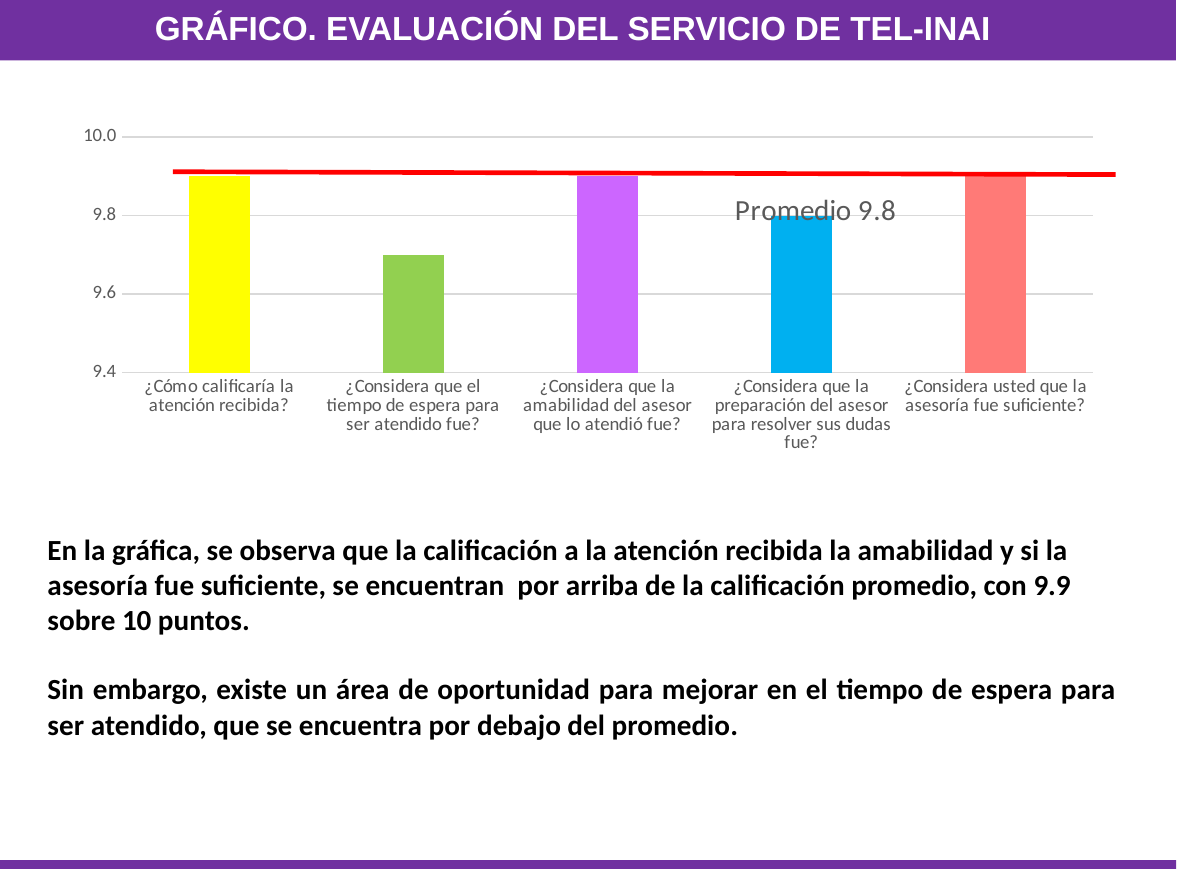
Is the value for '¿Considera que la amabilidad del asesor que lo atendió fue?' greater or less than 9.8? greater Is the value for '¿Considera usted que la asesoría fue suficiente?' greater or less than 9.8? greater What kind of chart is shown on the slide? bar chart Which is larger: the value for '¿Cómo calificaría la atención recibida?' or for '¿Considera que el tiempo de espera para ser atendido fue?'? ¿Cómo calificaría la atención recibida? Is the value for '¿Cómo calificaría la atención recibida?' greater or less than 9.6? greater Which category has the lowest value in the chart? ¿Considera que el tiempo de espera para ser atendido fue? What average value (Promedio) is marked by the red line on the chart? 9.8 What is the title of the chart on the slide? GRÁFICO. EVALUACIÓN DEL SERVICIO DE TEL-INAI Which is larger: the value for '¿Considera que la preparación del asesor para resolver sus dudas fue?' or for '¿Considera que el tiempo de espera para ser atendido fue?'? ¿Considera que la preparación del asesor para resolver sus dudas fue? What is the lowest value shown on the vertical axis of the chart? 9.4 How many categories (questions) are plotted in the chart? 5